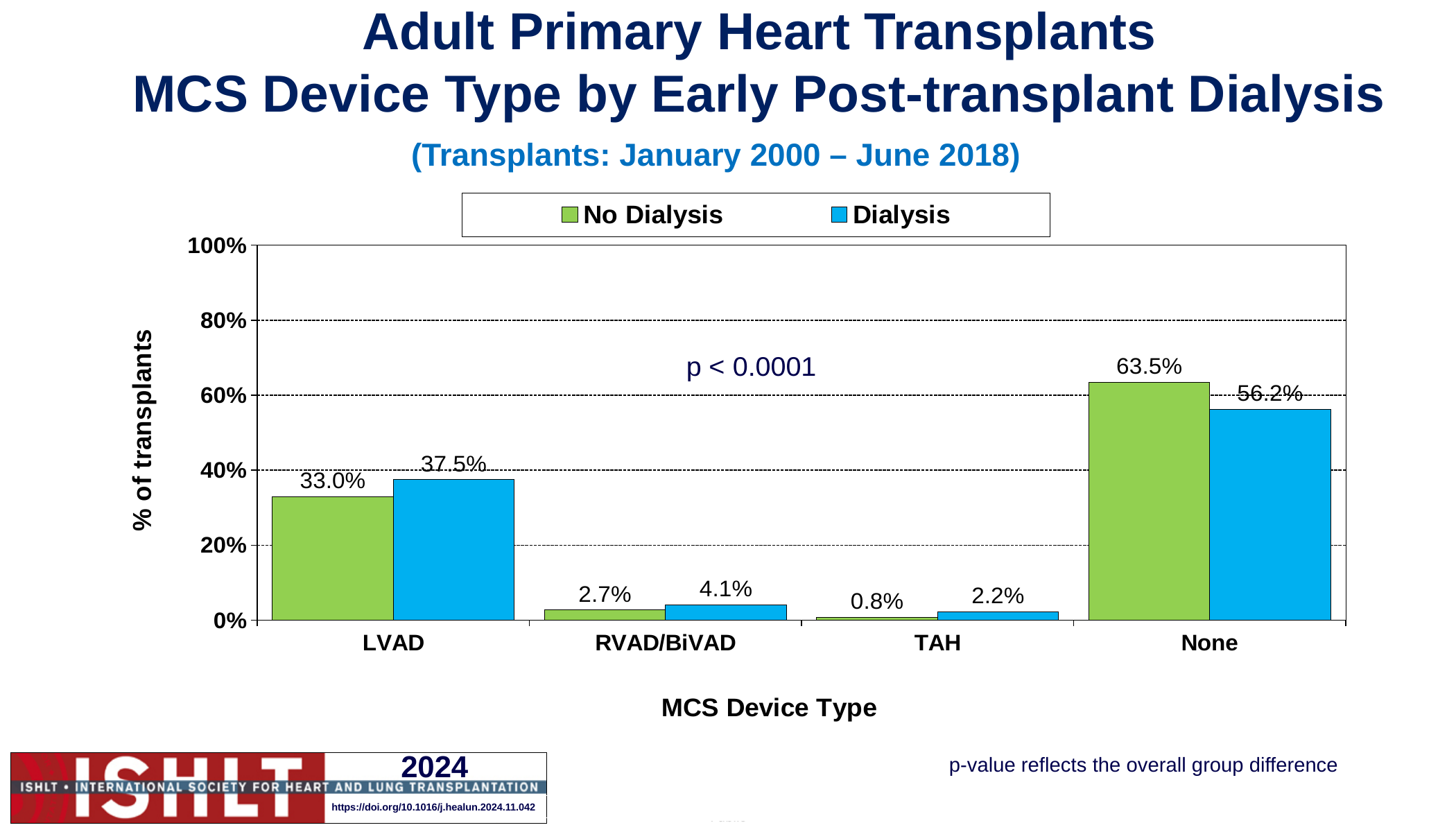
How many series does the legend list? 2 What p-value is printed on the chart? p < 0.0001 What is the difference between the No Dialysis and Dialysis values for None? 7.3% What is the Dialysis value for TAH? 2.2% What kind of chart is shown on the slide? Bar chart Which MCS device type has the highest No Dialysis value? None Which MCS device type has the lowest Dialysis value? TAH How many MCS device type categories are shown on the x axis? 4 What is the No Dialysis value for LVAD? 33.0% What is the Dialysis value for None? 56.2% For RVAD/BiVAD, which is larger: the No Dialysis value or the Dialysis value? Dialysis What is the difference between the Dialysis and No Dialysis values for LVAD? 4.5%